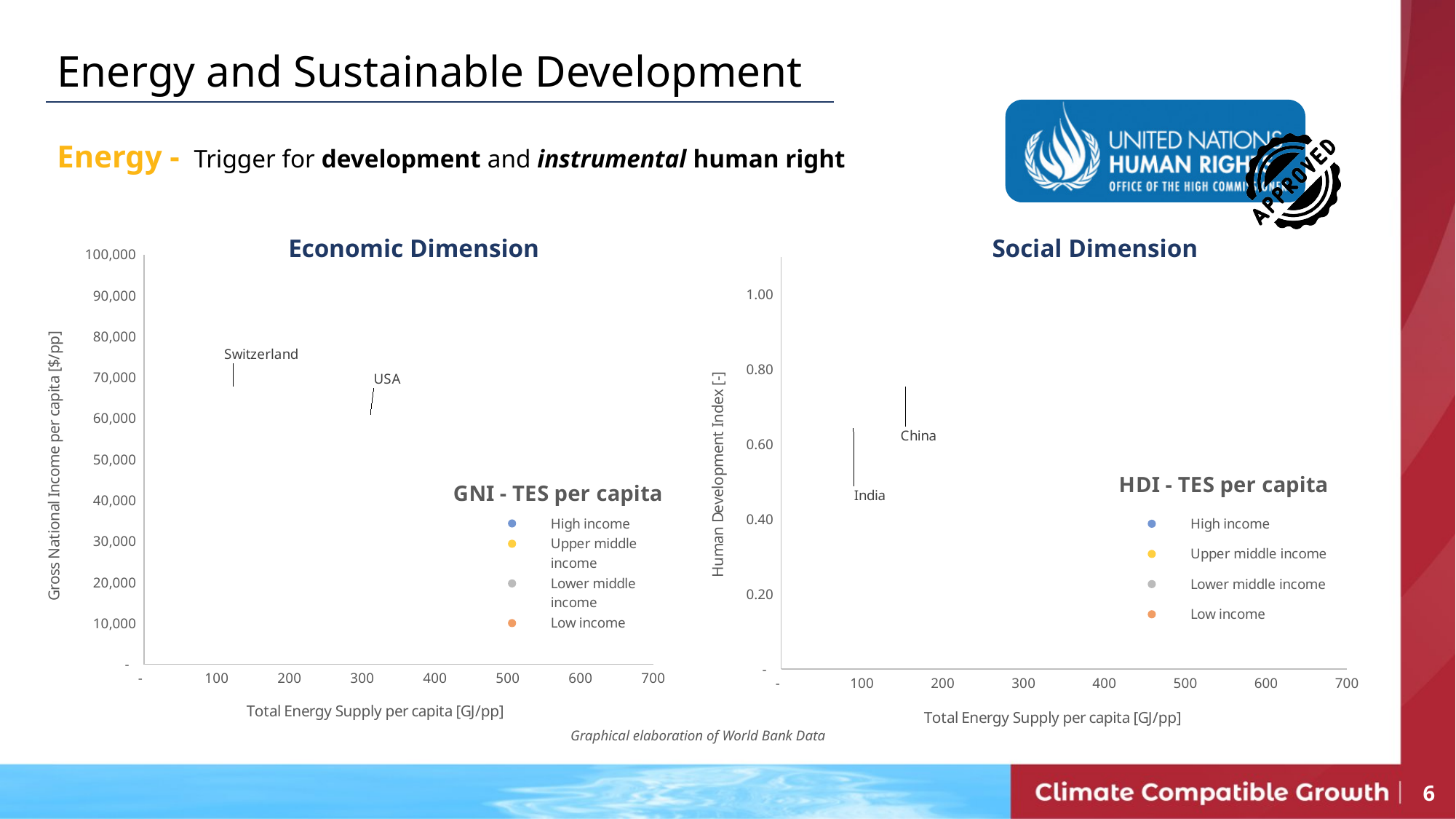
In the Social Dimension chart, which labelled country has the higher Human Development Index, China or India? China What kind of chart is the Economic Dimension chart? scatter chart In the Economic Dimension chart, is the Gross National Income per capita for Switzerland greater or less than 60,000? greater In the Social Dimension chart, what is the title of the x axis? Total Energy Supply per capita [GJ/pp] In the Social Dimension chart, is the Total Energy Supply per capita for China greater or less than 300? less In the Economic Dimension chart, is the Total Energy Supply per capita for Switzerland greater or less than 200? less In the Economic Dimension chart, what is the title of the y axis? Gross National Income per capita [$/pp] How many series does the legend of the Social Dimension chart list? 4 In the Economic Dimension chart, which labelled country has the higher Gross National Income per capita, Switzerland or the USA? Switzerland How many countries are labelled by name in the Social Dimension chart? 2